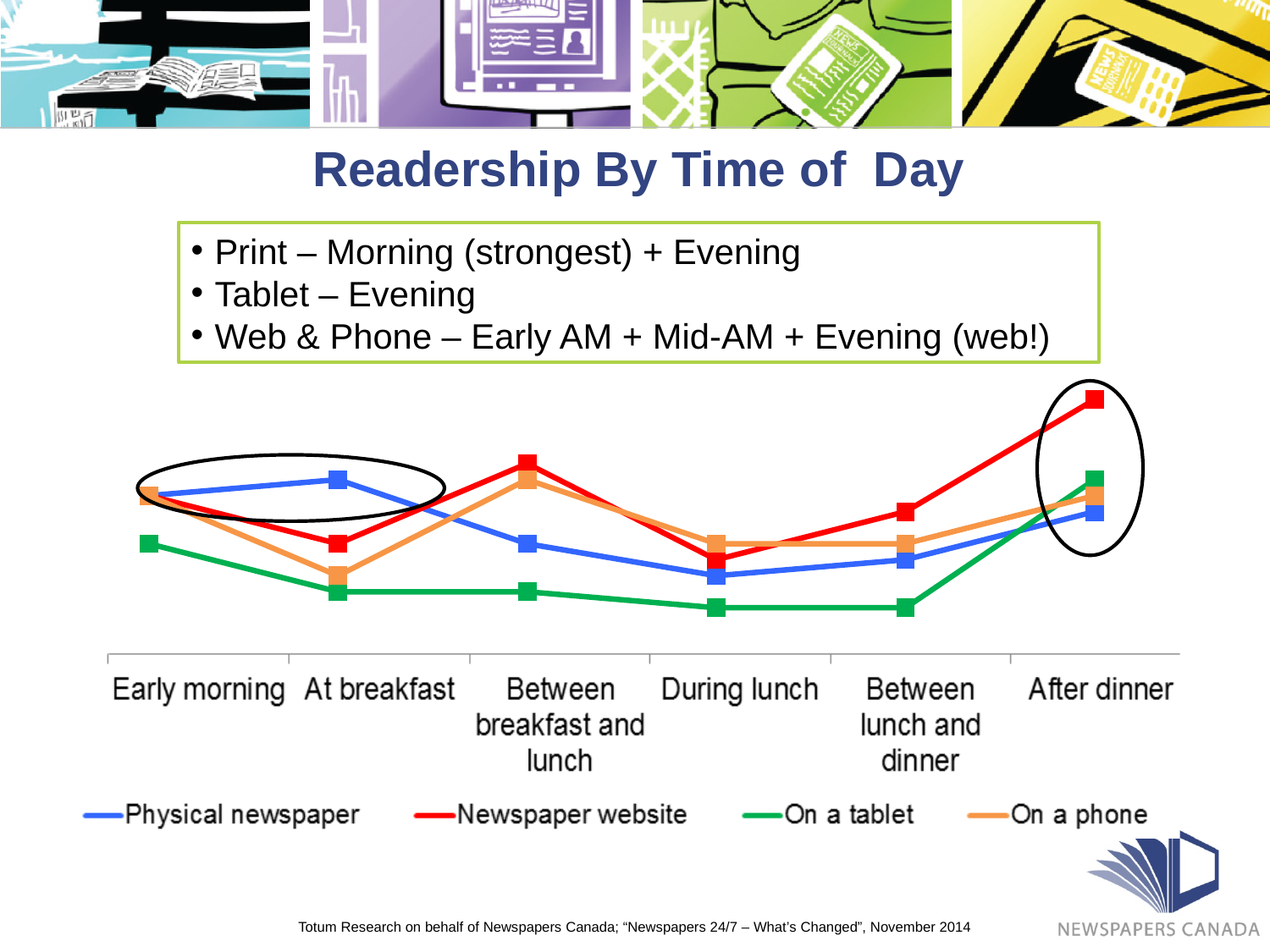
How many series does the chart's legend list? 4 At which time of day is the On a phone series at its lowest? At breakfast Does the On a tablet series rise or fall from Between lunch and dinner to After dinner? Rises Which series has the highest value at After dinner? Newspaper website At which time of day is the On a tablet series at its highest? After dinner What kind of chart is shown on the slide? Line chart Which series has the lowest value at During lunch? On a tablet What colour is the Newspaper website line in the chart? Red At Early morning, which is higher: Physical newspaper or On a tablet? Physical newspaper At which time of day is the Physical newspaper series at its lowest? During lunch How many time-of-day categories are shown along the x axis of the chart? 6 Does the Physical newspaper series rise or fall from At breakfast to During lunch? Falls